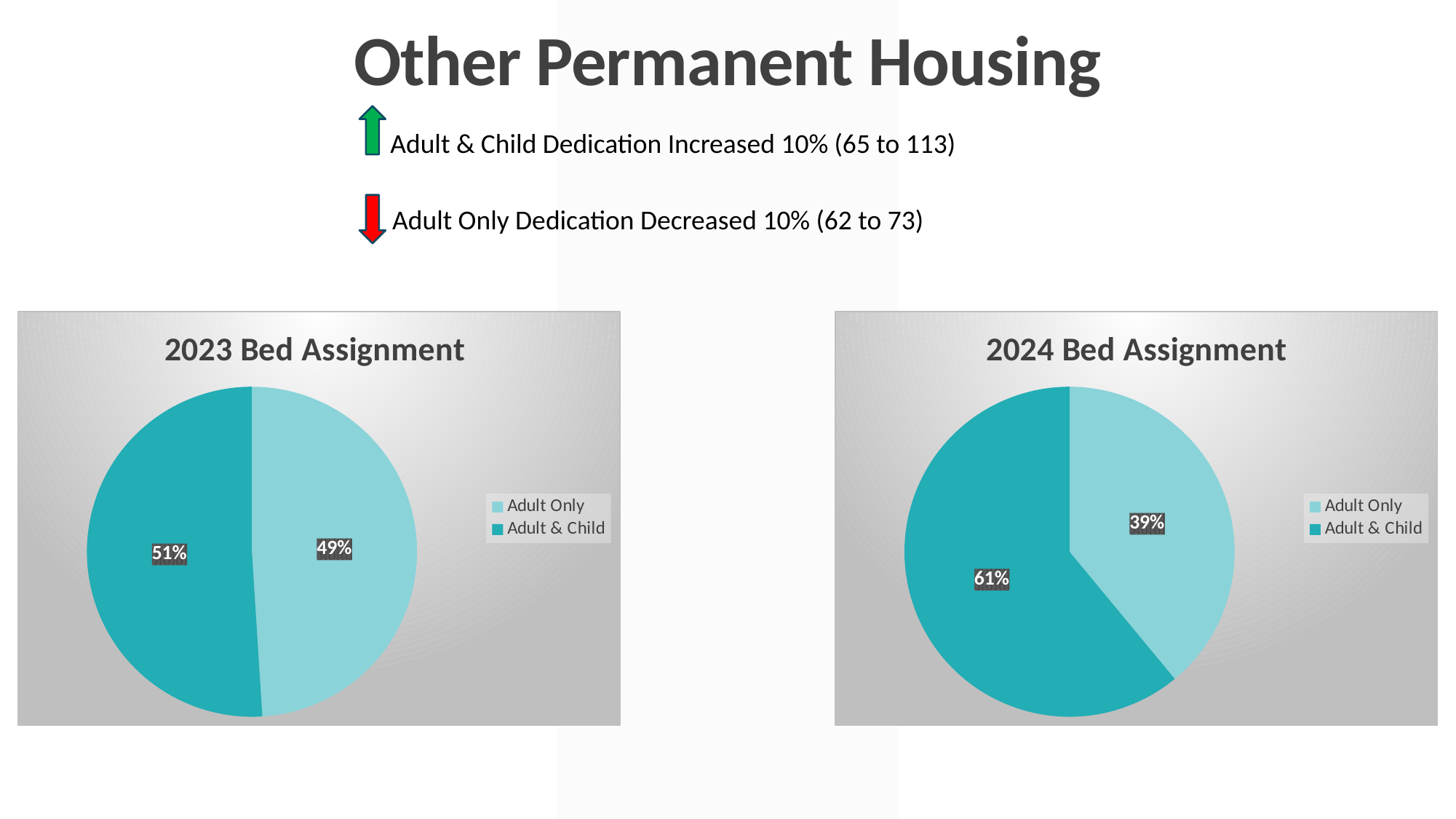
In the 2023 Bed Assignment chart, what share is Adult Only? 49% How many slices does the 2024 Bed Assignment pie chart have? 2 How many entries does the legend of the 2023 Bed Assignment chart list? 2 In the 2023 Bed Assignment chart, what is the difference between the Adult & Child share and the Adult Only share? 2% In the 2024 Bed Assignment chart, which category has the largest slice? Adult & Child In the 2024 Bed Assignment chart, what is the difference between the Adult & Child share and the Adult Only share? 22% What kind of chart is the 2023 Bed Assignment chart? Pie chart In the 2024 Bed Assignment chart, what share is Adult Only? 39% In the 2024 Bed Assignment chart, what share is Adult & Child? 61% In the 2024 Bed Assignment chart, which category has the smallest slice? Adult Only What is the title of the chart on the right side of the slide? 2024 Bed Assignment In the 2023 Bed Assignment chart, what share is Adult & Child? 51%